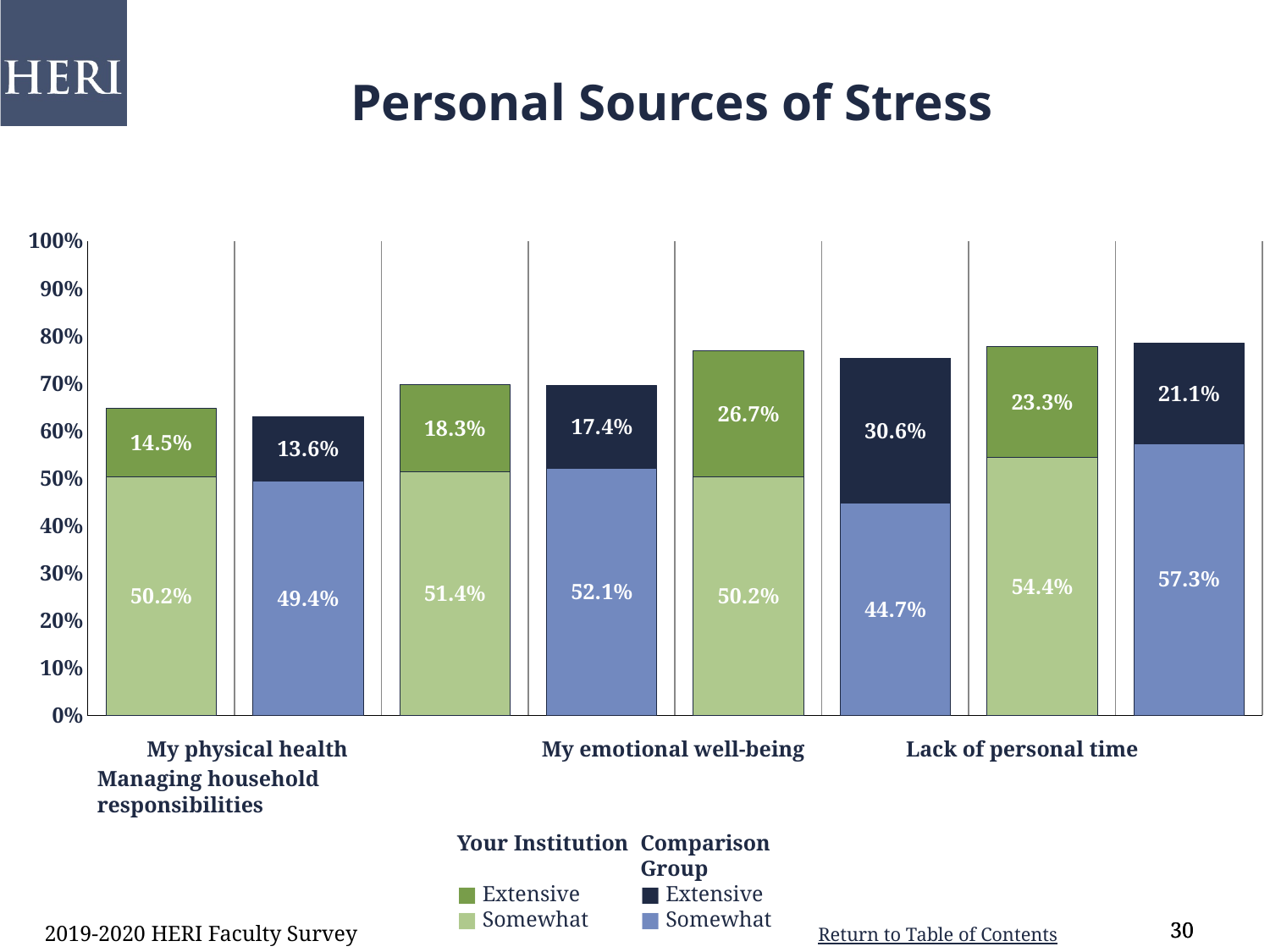
Which is larger for Lack of personal time: the Your Institution 'Somewhat' value or the Comparison Group 'Somewhat' value? Your Institution How many stress categories are shown on the x axis? 4 What type of chart is shown on the slide? Stacked bar chart What is the difference between the Your Institution and Comparison Group 'Extensive' values for My emotional well-being? 0.9% Which category has the highest Comparison Group 'Extensive' value? Lack of personal time What percentage of Your Institution faculty reported 'Somewhat' stress from My physical health? 50.2% Which category has the lowest Your Institution 'Extensive' value? My physical health What is the total of the Your Institution stacked bar for My physical health? 64.7% What is the total of the Comparison Group stacked bar for Lack of personal time? 75.3% What is the Comparison Group 'Somewhat' value for Managing household responsibilities? 57.3% What is the Comparison Group 'Extensive' value for My emotional well-being? 17.4% What is the Your Institution 'Extensive' value for Lack of personal time? 26.7%